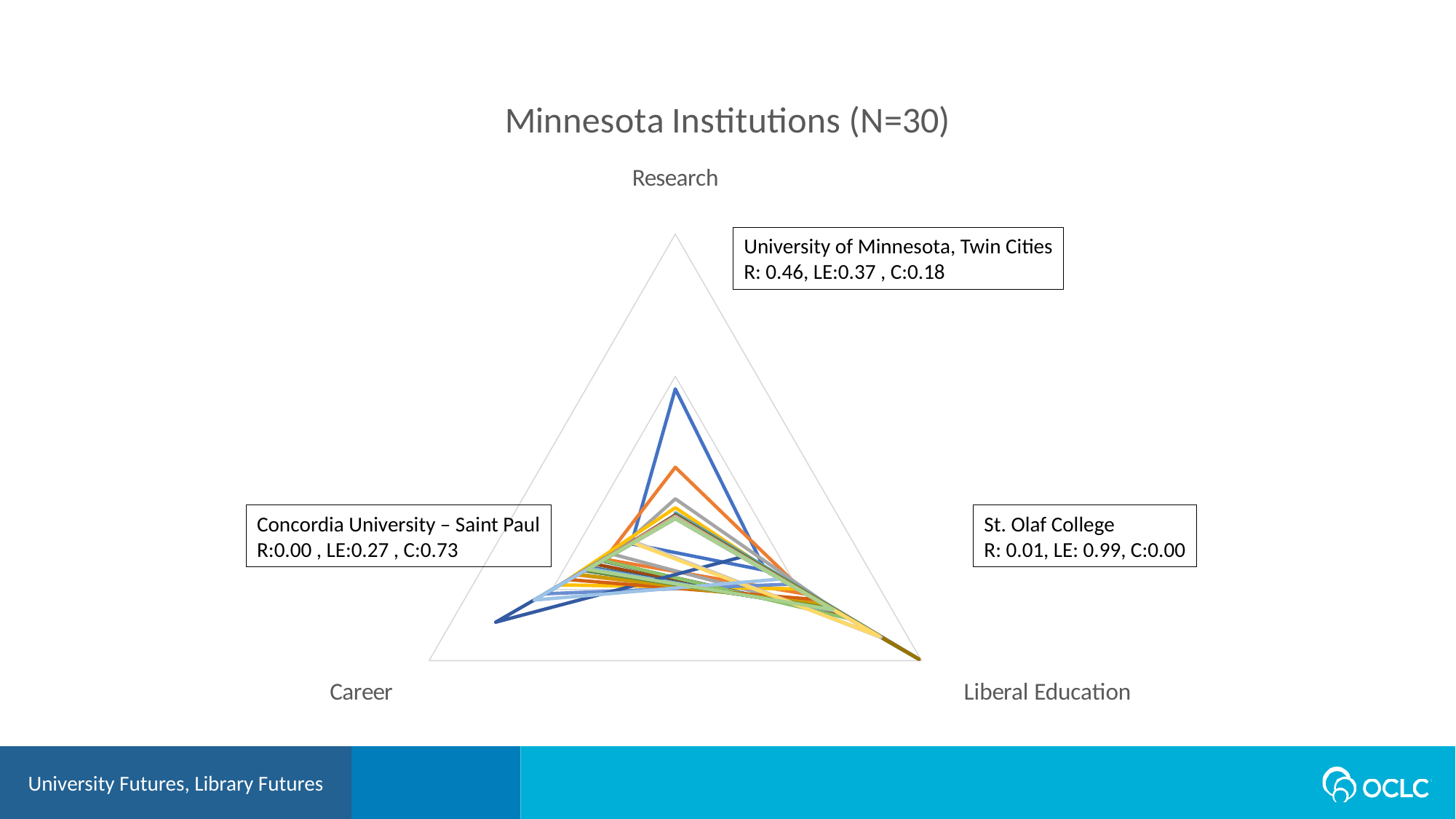
What is the Liberal Education (LE) value for St. Olaf College? 0.99 What is the difference between the Career (C) values of Concordia University – Saint Paul and University of Minnesota, Twin Cities? 0.55 What is the Career (C) value for University of Minnesota, Twin Cities? 0.18 Which of the three annotated institutions has the highest Research (R) value? University of Minnesota, Twin Cities What is the title of the chart? Minnesota Institutions (N=30) How many institutions are included in the chart according to the title? 30 What kind of chart is shown on the slide? Radar chart How many axes (categories) does the radar chart have? 3 What are the three axis labels on the radar chart? Research, Liberal Education, Career What is the Career (C) value for Concordia University – Saint Paul? 0.73 Which has a higher Liberal Education (LE) value, St. Olaf College or Concordia University – Saint Paul? St. Olaf College What is the Research (R) value for University of Minnesota, Twin Cities? 0.46